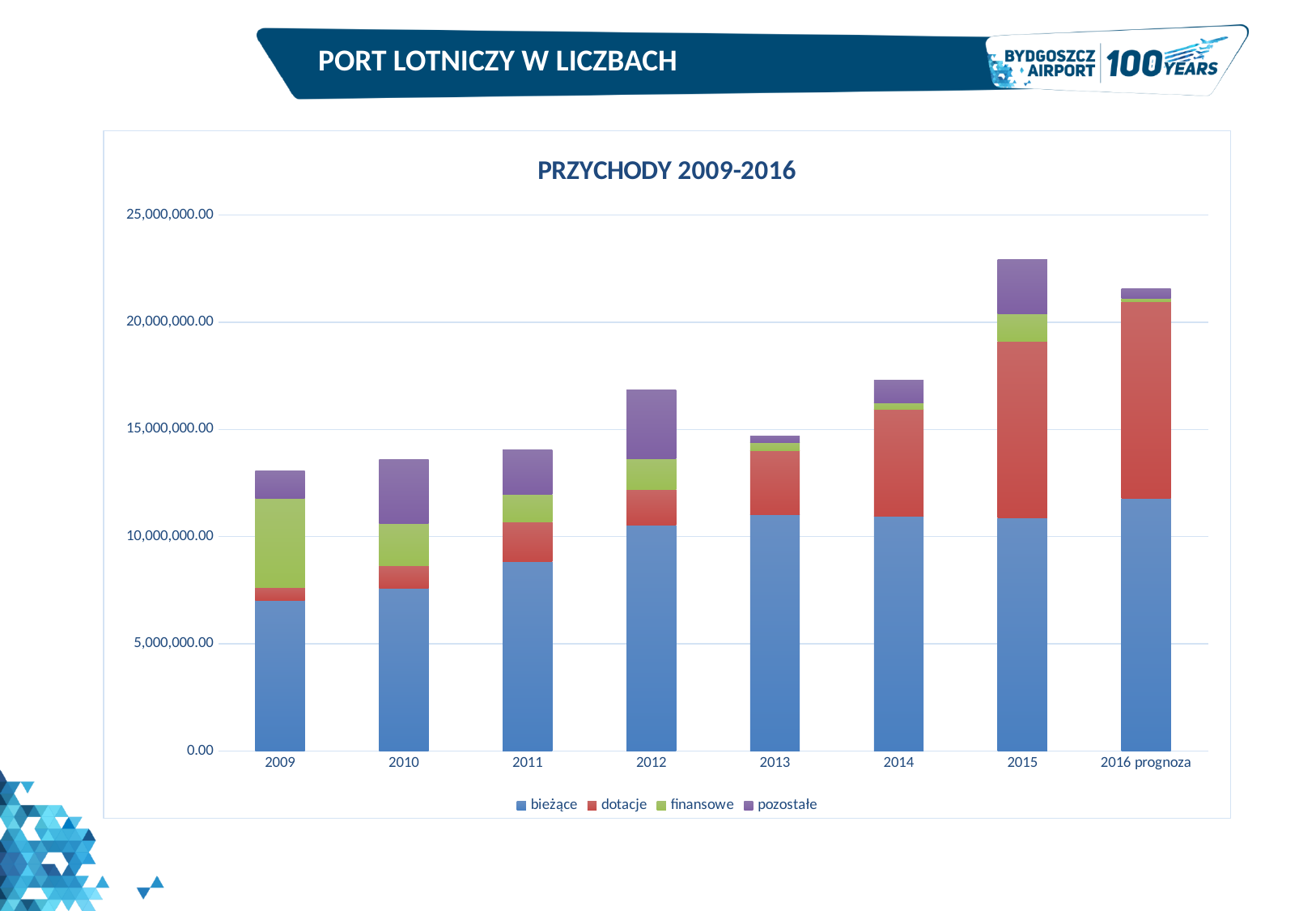
Which year has the highest total revenue bar? 2015 Which year has the largest finansowe segment? 2009 Which total bar is taller, 2015 or 2016 prognoza? 2015 What type of chart is shown on the slide? Stacked bar chart Is the total bar for 2013 greater or less than 15,000,000.00? less How many series does the legend list? 4 Is the total bar for 2015 greater or less than 20,000,000.00? greater Is the bieżące segment for 2016 prognoza greater or less than 10,000,000.00? greater Which year has the lowest total revenue bar? 2009 How many categories are shown on the x axis? 8 What is the title of the chart? PRZYCHODY 2009-2016